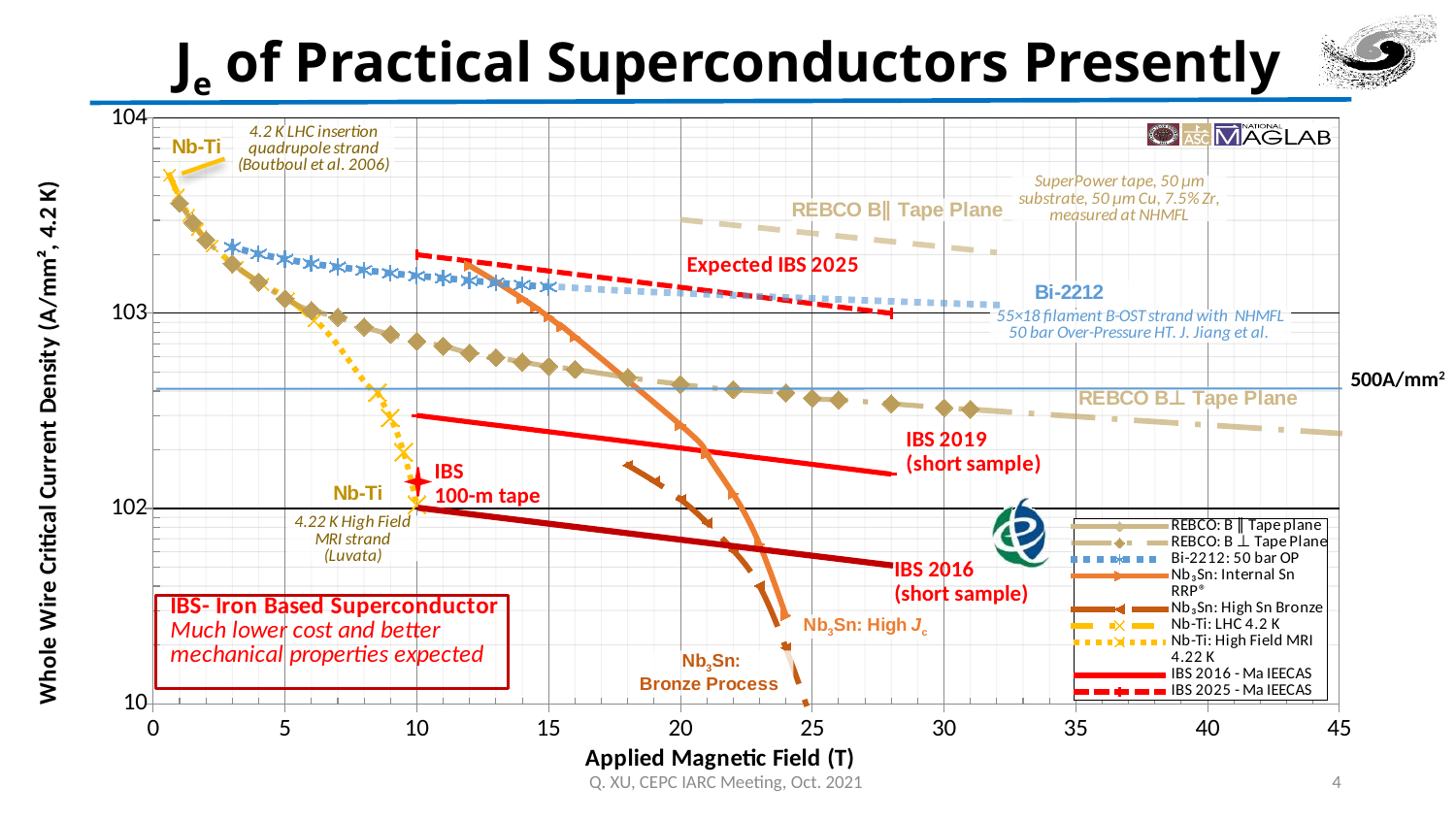
At 20 T, which series has the larger current density: Bi-2212 or Nb3Sn Internal Sn RRP? Bi-2212 Does the Bi-2212 curve rise or fall as the applied magnetic field increases? fall What is the title of the chart's x axis? Applied Magnetic Field (T) What value is labelled on the horizontal reference line drawn across the chart? 500A/mm² What kind of chart is shown on the slide? line chart How many series does the chart legend list? 9 Does the REBCO B⊥ Tape Plane curve rise or fall as the applied magnetic field increases? fall Is the value of the Nb3Sn Internal Sn RRP curve at 20 T greater or less than 1000? less Is the value of the IBS 2016 (short sample) curve at 28 T greater or less than 100? less Is the value of the IBS 2019 (short sample) curve at 28 T greater or less than 1000? less At 25 T, which series has the larger current density: REBCO B∥ Tape Plane or REBCO B⊥ Tape Plane? REBCO B∥ Tape Plane Which series extends to the highest applied magnetic field on the chart? REBCO B⊥ Tape Plane